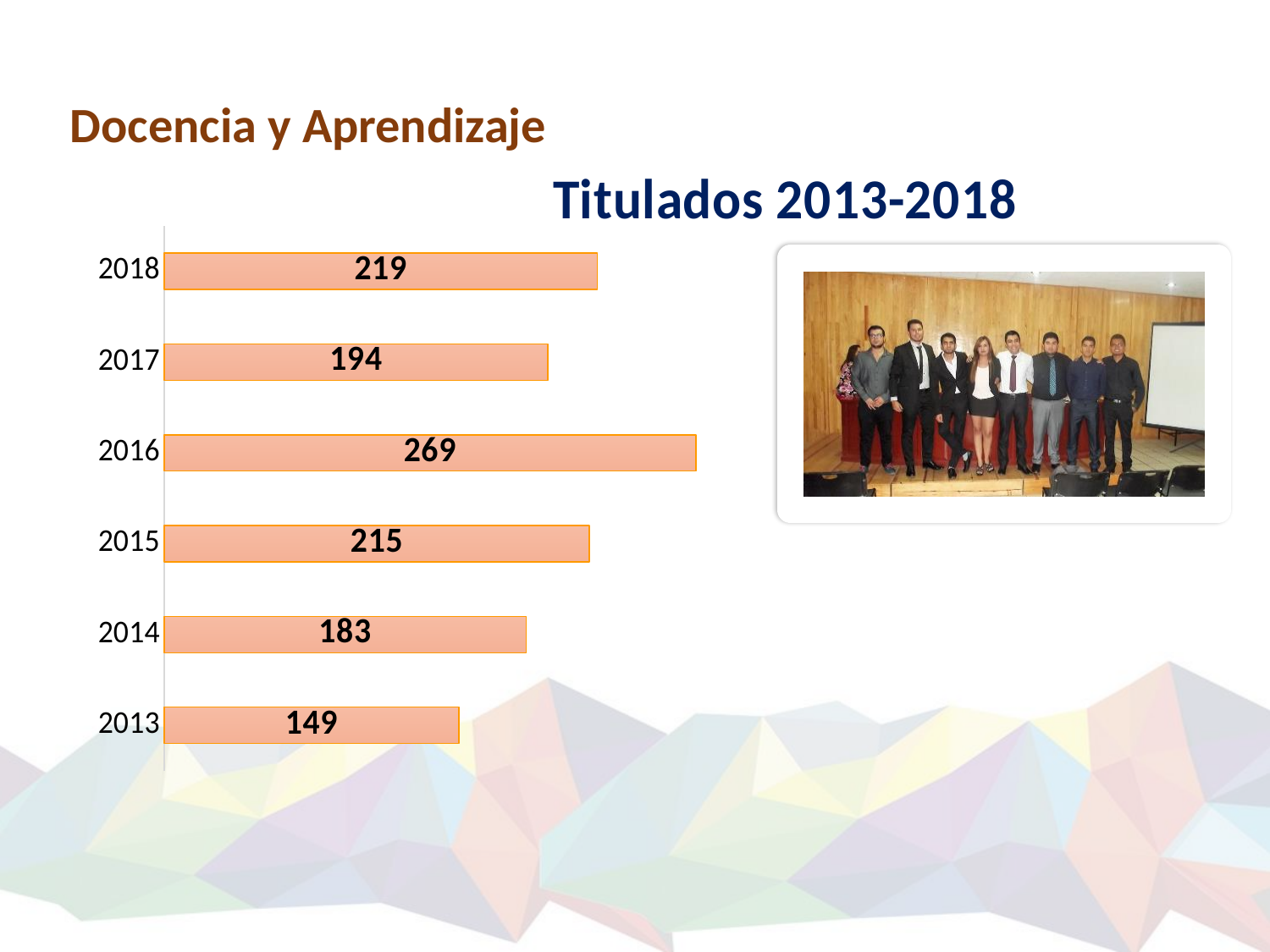
Which is larger, the value for 2015 or the value for 2014? 2015 What is the title of the chart? Titulados 2013-2018 What kind of chart is this? bar chart Which year has the lowest value? 2013 How many years are shown in the chart? 6 What is the value for 2013? 149 What is the value for 2016? 269 Which year has the highest value? 2016 What is the value for 2014? 183 What is the difference between the values for 2018 and 2013? 70 What is the difference between the values for 2016 and 2017? 75 What is the value for 2017? 194